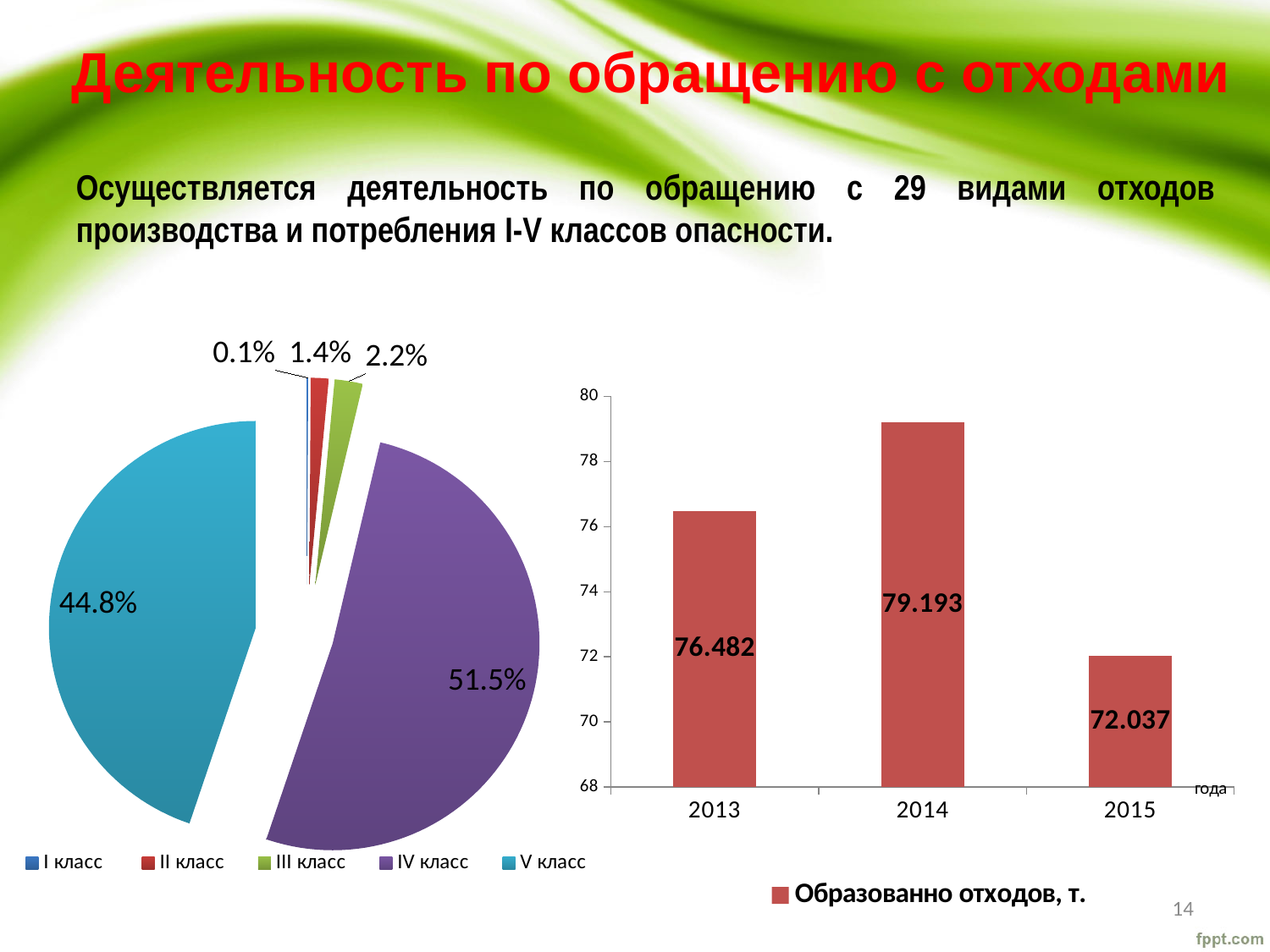
On the pie chart on the left, how many classes does the legend list? 5 On the bar chart on the right, what series name does the legend show? Образованно отходов, т. On the bar chart on the right, what is the value for 2014? 79.193 On the bar chart on the right, is the value for 2013 greater or less than 2015? greater On the pie chart on the left, what share does V класс have? 44.8% On the bar chart on the right, which year has the lowest value? 2015 On the pie chart on the left, what share does IV класс have? 51.5% On the pie chart on the left, which class has the largest share? IV класс On the pie chart on the left, what is the difference between the shares of IV класс and V класс? 6.7% On the pie chart on the left, what share does I класс have? 0.1% On the pie chart on the left, which class has the smallest share? I класс On the bar chart on the right, what is the value for 2015? 72.037